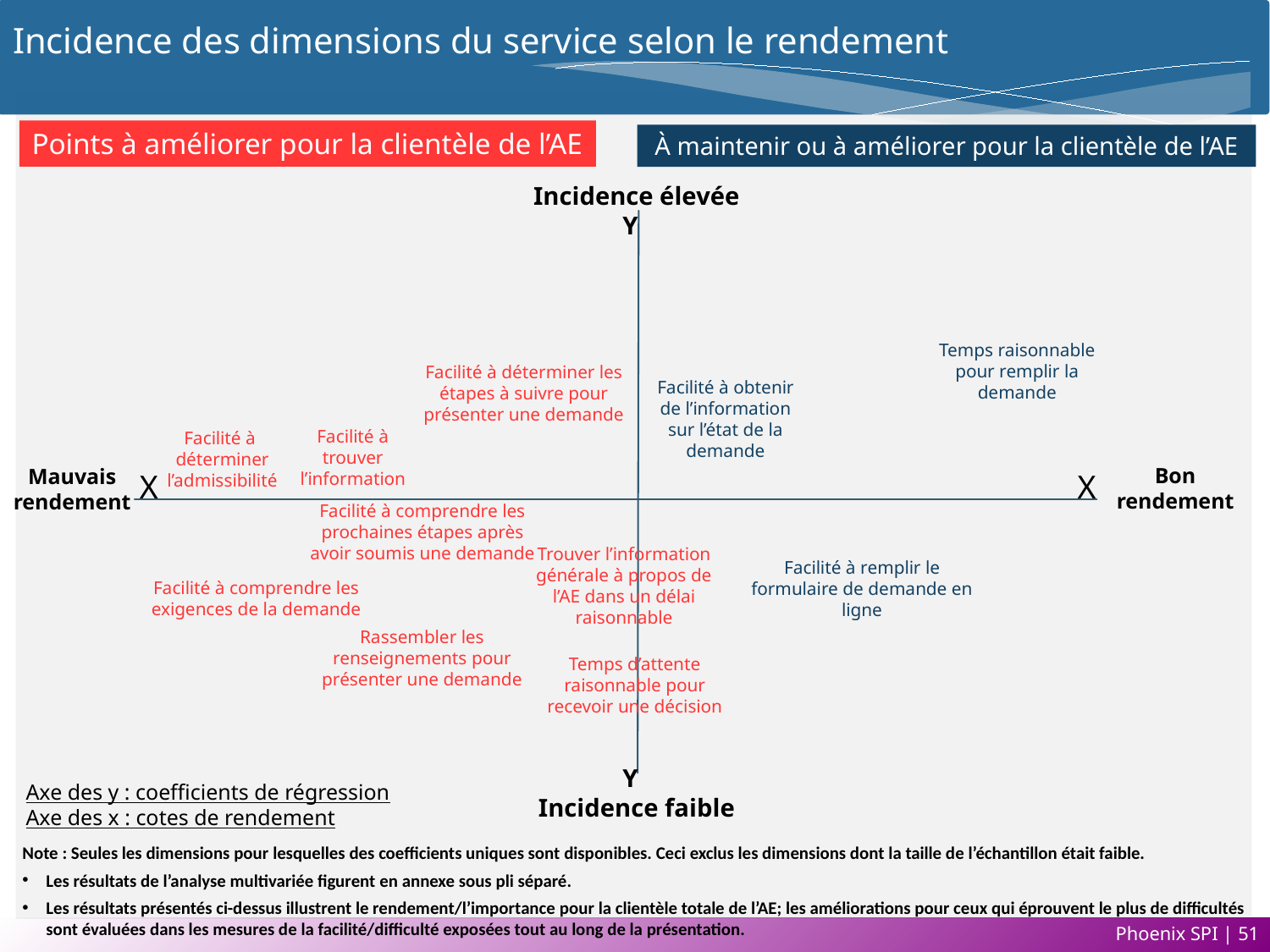
In which quadrant is 'Facilité à remplir le formulaire de demande en ligne' located? Bottom right (incidence faible, bon rendement) What kind of chart is shown on the slide? A quadrant (scatter-style) chart Which service dimension is plotted lowest on the chart (lowest incidence)? Temps d'attente raisonnable pour recevoir une décision Which service dimension is plotted furthest to the left (worst performance)? Facilité à déterminer l'admissibilité How many service dimensions are plotted on the chart? 11 Which service dimension is plotted highest on the chart (highest incidence)? Temps raisonnable pour remplir la demande How many service dimensions are shown in dark blue (à maintenir ou à améliorer)? 3 How many service dimensions are shown in red (points à améliorer)? 8 Which has the better performance rating: 'Facilité à déterminer l'admissibilité' or 'Facilité à obtenir de l'information sur l'état de la demande'? Facilité à obtenir de l'information sur l'état de la demande Which has the higher incidence: 'Facilité à remplir le formulaire de demande en ligne' or 'Temps raisonnable pour remplir la demande'? Temps raisonnable pour remplir la demande What does the y axis of the chart represent? Coefficients de régression What does the x axis of the chart represent? Cotes de rendement